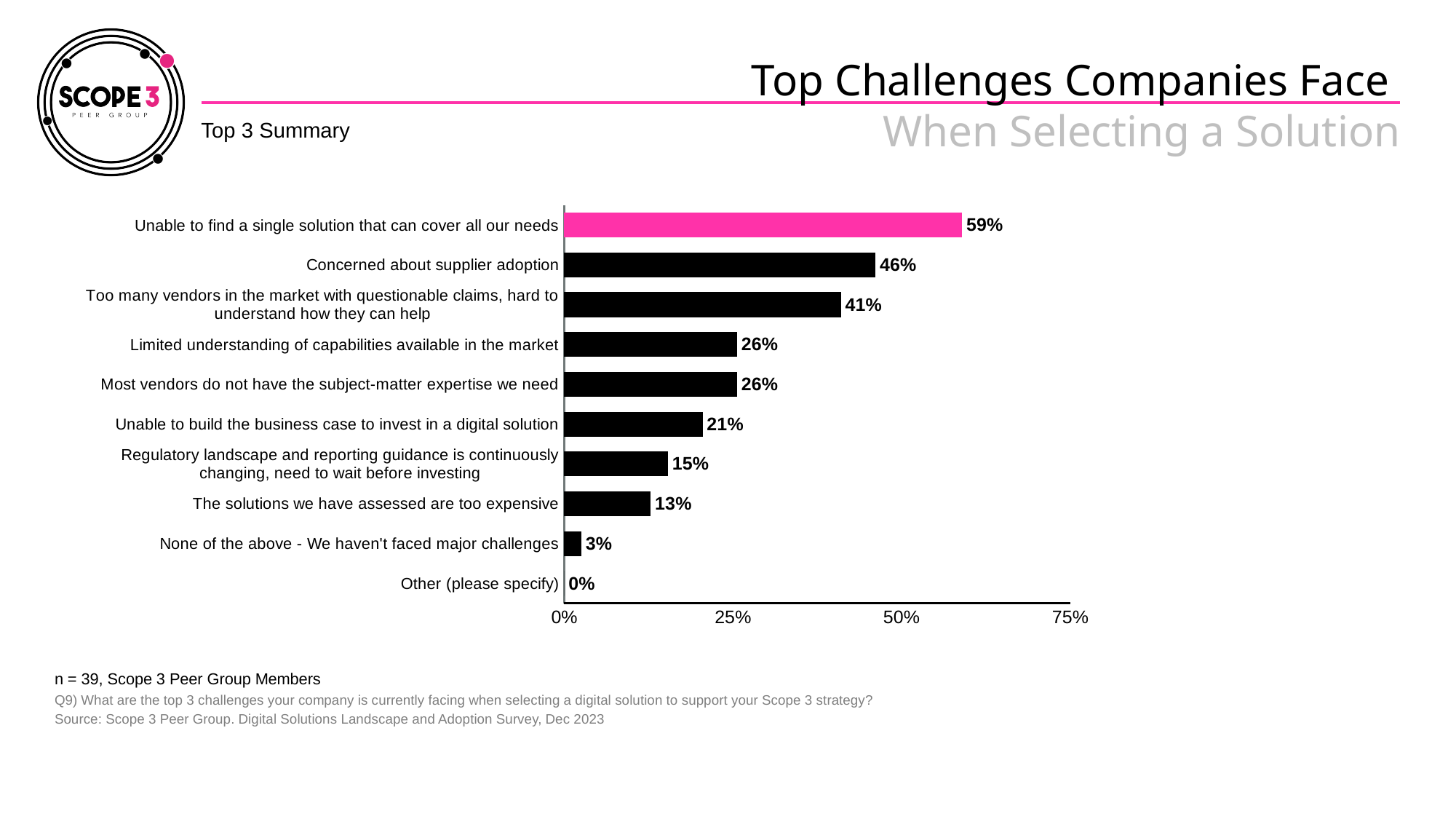
Is the value for "Too many vendors in the market with questionable claims, hard to understand how they can help" greater or less than 50%? less Which bar is highlighted in pink? Unable to find a single solution that can cover all our needs Which challenge has the highest percentage? Unable to find a single solution that can cover all our needs What percentage is shown for "The solutions we have assessed are too expensive"? 13% How many categories are shown in the chart? 10 Which category has the lowest value? Other (please specify) Which is larger: "Unable to build the business case to invest in a digital solution" or "Regulatory landscape and reporting guidance is continuously changing, need to wait before investing"? Unable to build the business case to invest in a digital solution What percentage of respondents selected "Unable to find a single solution that can cover all our needs"? 59% What is the value for "Concerned about supplier adoption"? 46% What kind of chart is shown on the slide? Bar chart What is the difference between "Unable to find a single solution that can cover all our needs" and "Concerned about supplier adoption"? 13% What is the value for "None of the above - We haven't faced major challenges"? 3%